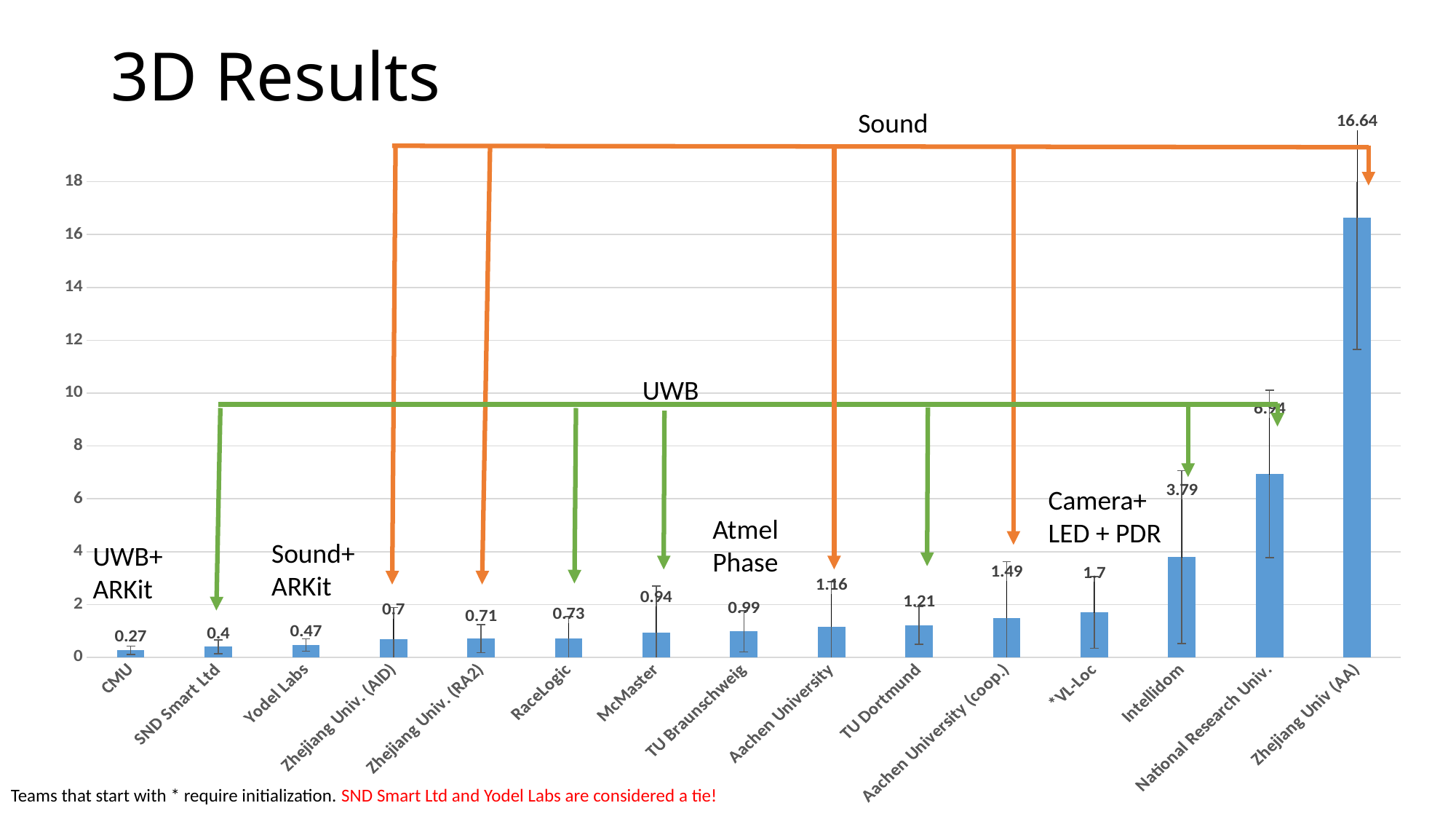
Is the value for National Research Univ. greater or less than 6? greater Which category has the lowest value? CMU How many categories are shown on the x axis? 15 Which category has the highest value? Zhejiang Univ (AA) Which is larger, the value for TU Dortmund or the value for Aachen University? TU Dortmund Do the values rise or fall from left to right along the x axis? rise What is the difference between the values for Intellidom and *VL-Loc? 2.09 What is the difference between the values for Zhejiang Univ (AA) and Intellidom? 12.85 What kind of chart is shown on the slide? bar chart What is the value for CMU? 0.27 What is the value for Intellidom? 3.79 What is the value for Aachen University (coop.)? 1.49